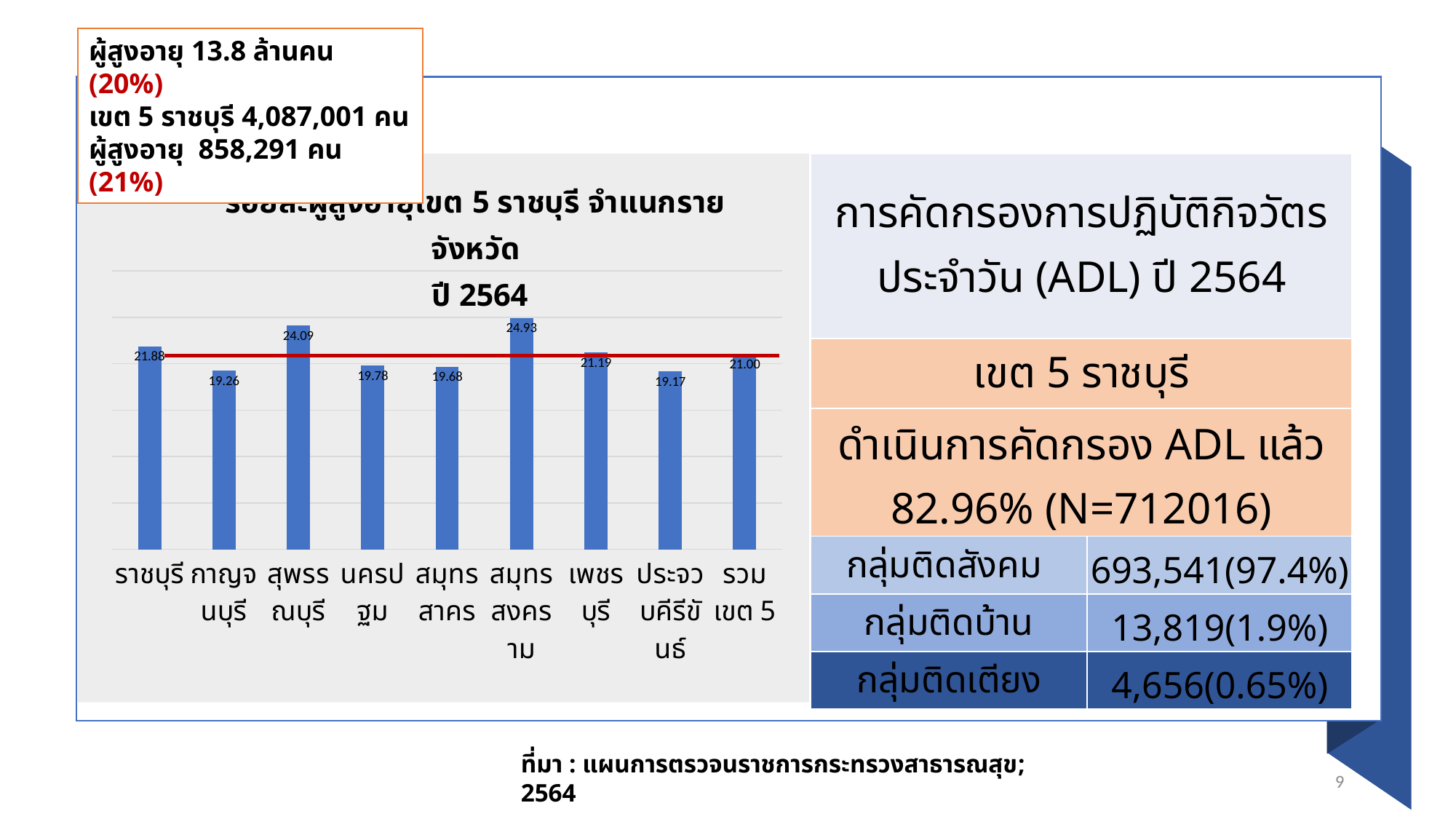
What is the difference between the values for สุพรรณบุรี and กาญจนบุรี in the bar chart? 4.83 Which category has the highest value in the bar chart? สมุทรสงคราม How many provinces/categories are plotted in the bar chart? 9 What is the difference between the values for สมุทรสงคราม and ประจวบคีรีขันธ์ in the bar chart? 5.76 In the bar chart, which is larger: the value for ราชบุรี or the value for เพชรบุรี? ราชบุรี What is the value shown for สมุทรสงคราม in the bar chart? 24.93 Which year does the bar chart title say the data is for? ปี 2564 What is the value shown for รวมเขต 5 in the bar chart? 21.00 What type of chart is shown on the left of the slide? bar chart Which category has the lowest value in the bar chart? ประจวบคีรีขันธ์ What is the value shown for ราชบุรี in the bar chart? 21.88 What is the value shown for นครปฐม in the bar chart? 19.78